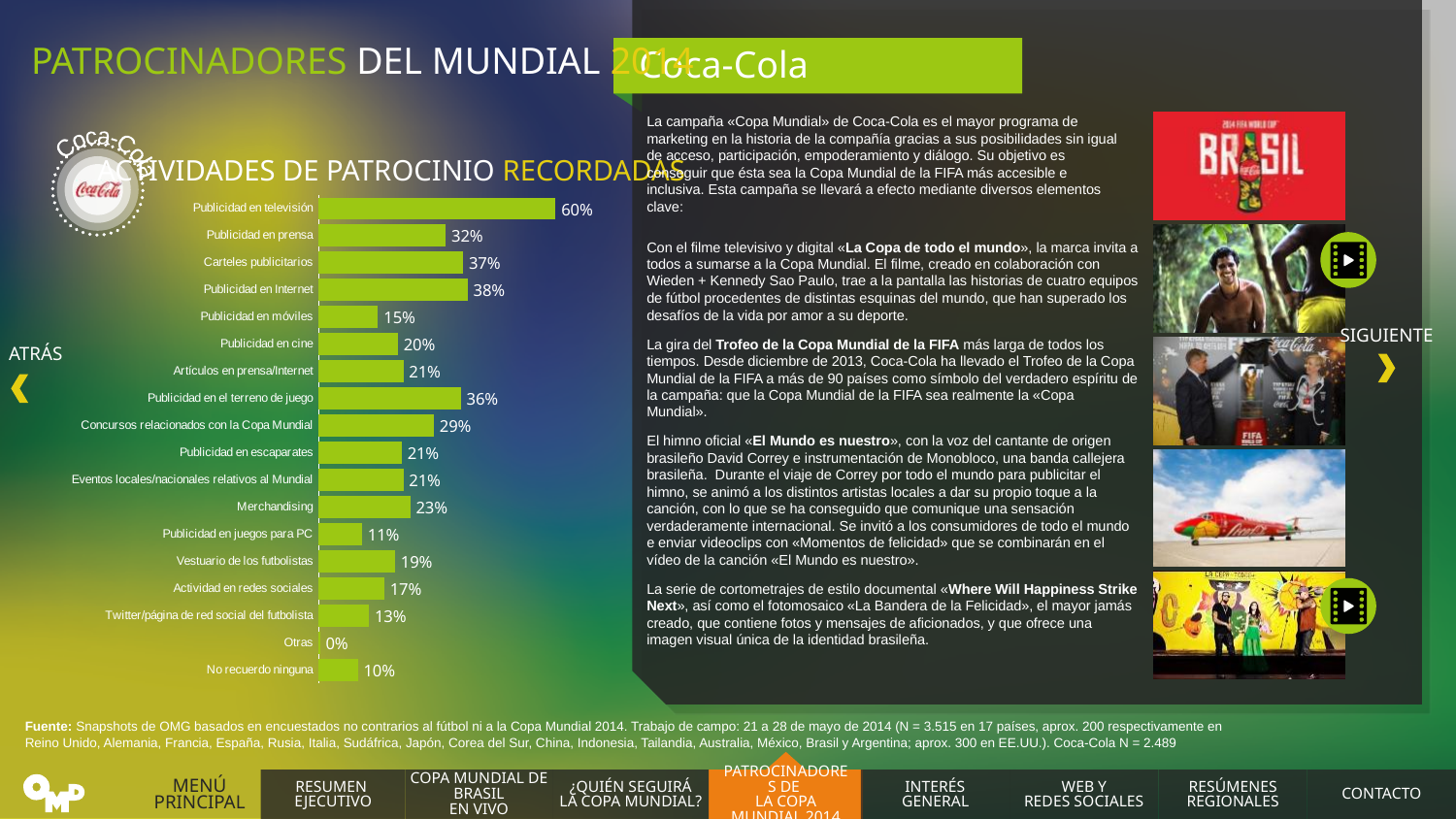
What is the value for Publicidad en Internet? 38% What is the value for Publicidad en televisión? 60% What is the difference between Carteles publicitarios and Publicidad en móviles? 22% What is the difference between Publicidad en televisión and Publicidad en prensa? 28% Which is larger, Publicidad en el terreno de juego or Concursos relacionados con la Copa Mundial? Publicidad en el terreno de juego Which category has the lowest value? Otras What is the value for No recuerdo ninguna? 10% What kind of chart is shown on the slide? Bar chart What is the title of the chart? ACTIVIDADES DE PATROCINIO RECORDADAS Which category has the highest value? Publicidad en televisión What is the value for Merchandising? 23% How many categories are shown in the chart? 18